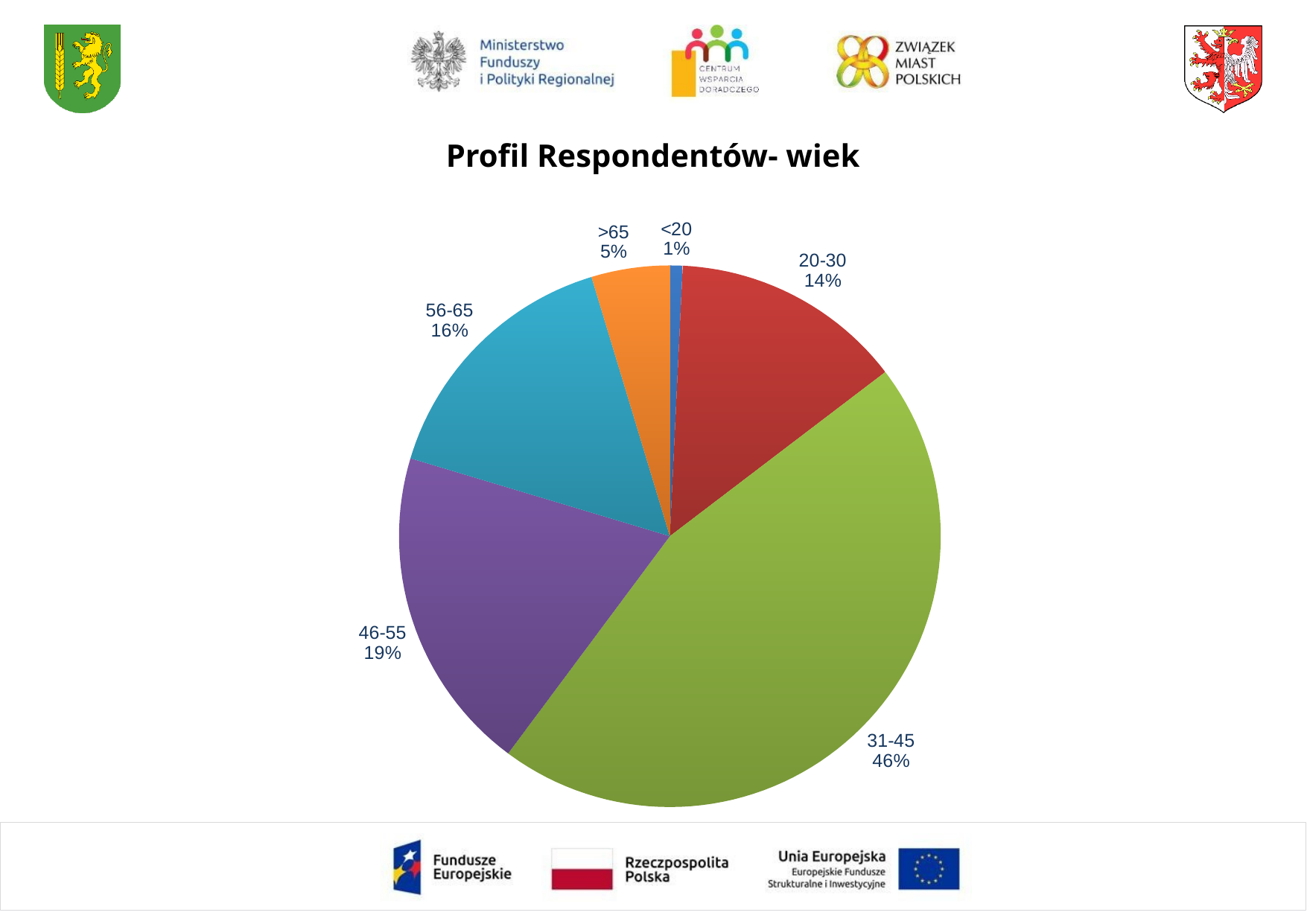
What share of respondents are in the 31-45 age group? 46% What is the combined share of the 46-55 and 56-65 age groups? 35% What percentage is shown for the 56-65 age group? 16% What is the difference in percentage points between the 46-55 and 20-30 age groups? 5 Which age group has the smallest share of respondents? <20 What type of chart is shown on the slide? pie chart What percentage is shown for the <20 age group? 1% What is the title of the chart? Profil Respondentów- wiek Which has a larger share, the 56-65 group or the >65 group? 56-65 Which age group has the largest share of respondents? 31-45 What colour is the slice for the 31-45 age group? green How many age groups are shown in the pie chart? 6